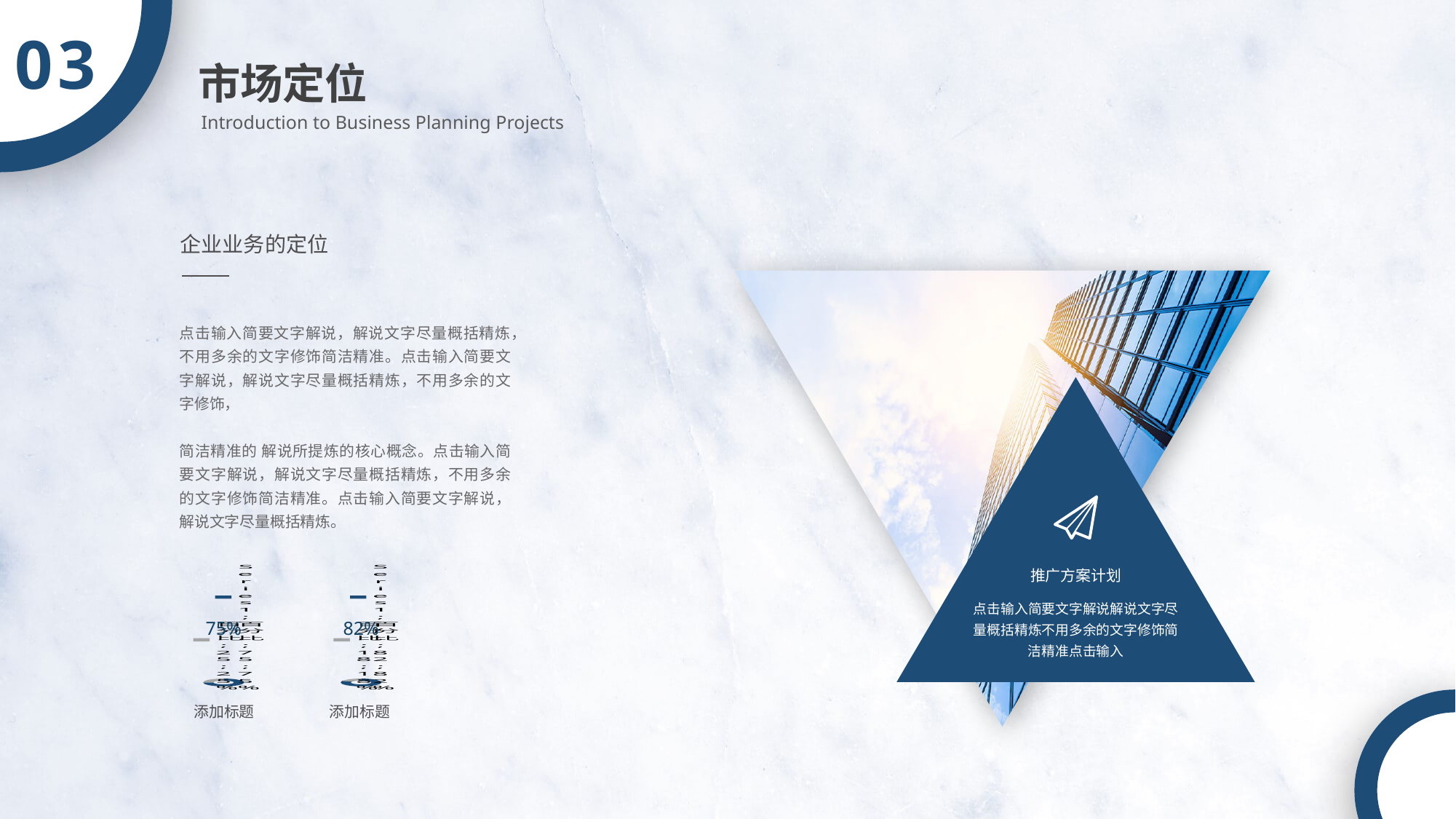
Is the percentage shown on the right chart greater or less than 80%? greater Which of the two small charts at the bottom left shows the larger percentage, the left one or the right one? the right one (82%) What percentage is shown on the right chart above the label 添加标题? 82% What caption appears below each of the two small charts? 添加标题 How many small charts are shown at the bottom left of the slide? 2 Is the percentage shown on the left chart greater or less than 80%? less What percentage is shown on the left chart above the label 添加标题? 75% What is the difference between the percentage on the right chart (82%) and the percentage on the left chart (75%)? 7 percentage points